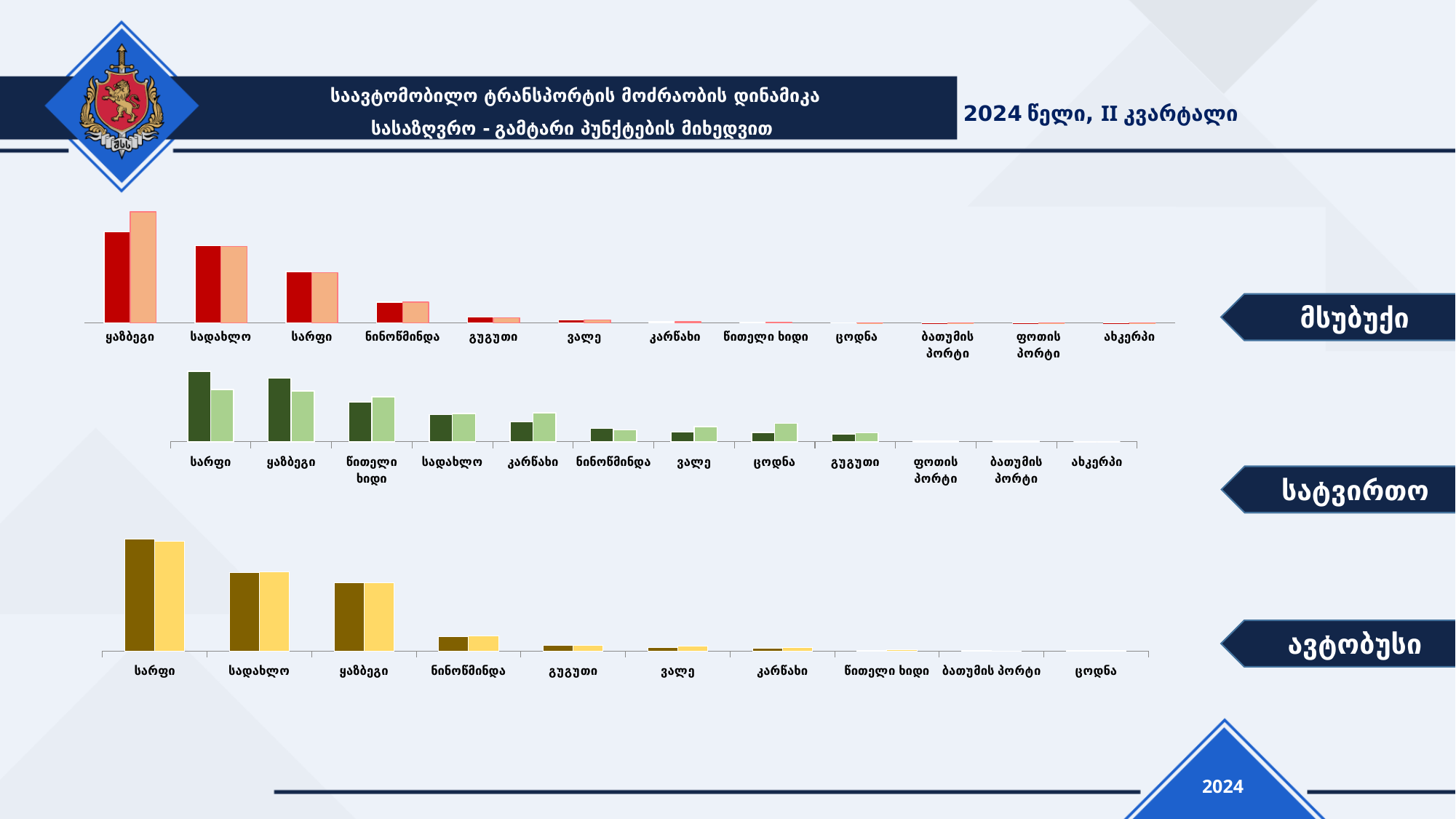
In the სატვირთო chart (middle), which category has the tallest bar? სარფი In the სატვირთო chart (middle), how many categories are shown on the x axis? 12 In the მსუბუქი chart (top), which category has the tallest bars? ყაზბეგი In the მსუბუქი chart (top), do the bar heights generally rise or fall from left to right along the x axis? fall How many charts are shown on the slide? 3 In the სატვირთო chart (middle), for ცოდნა, is the dark green bar or the light green bar taller? the light green bar In the ავტობუსი chart (bottom), how many categories are shown on the x axis? 10 In the მსუბუქი chart (top), for ყაზბეგი, is the red bar or the light orange bar taller? the light orange bar In the ავტობუსი chart (bottom), which is taller: the bar for სადახლო or the bar for ნინოწმინდა? სადახლო In the მსუბუქი chart (top), how many categories are shown on the x axis? 12 In the ავტობუსი chart (bottom), which category has the tallest bars? სარფი What kind of chart is used for the მსუბუქი data at the top of the slide? bar chart